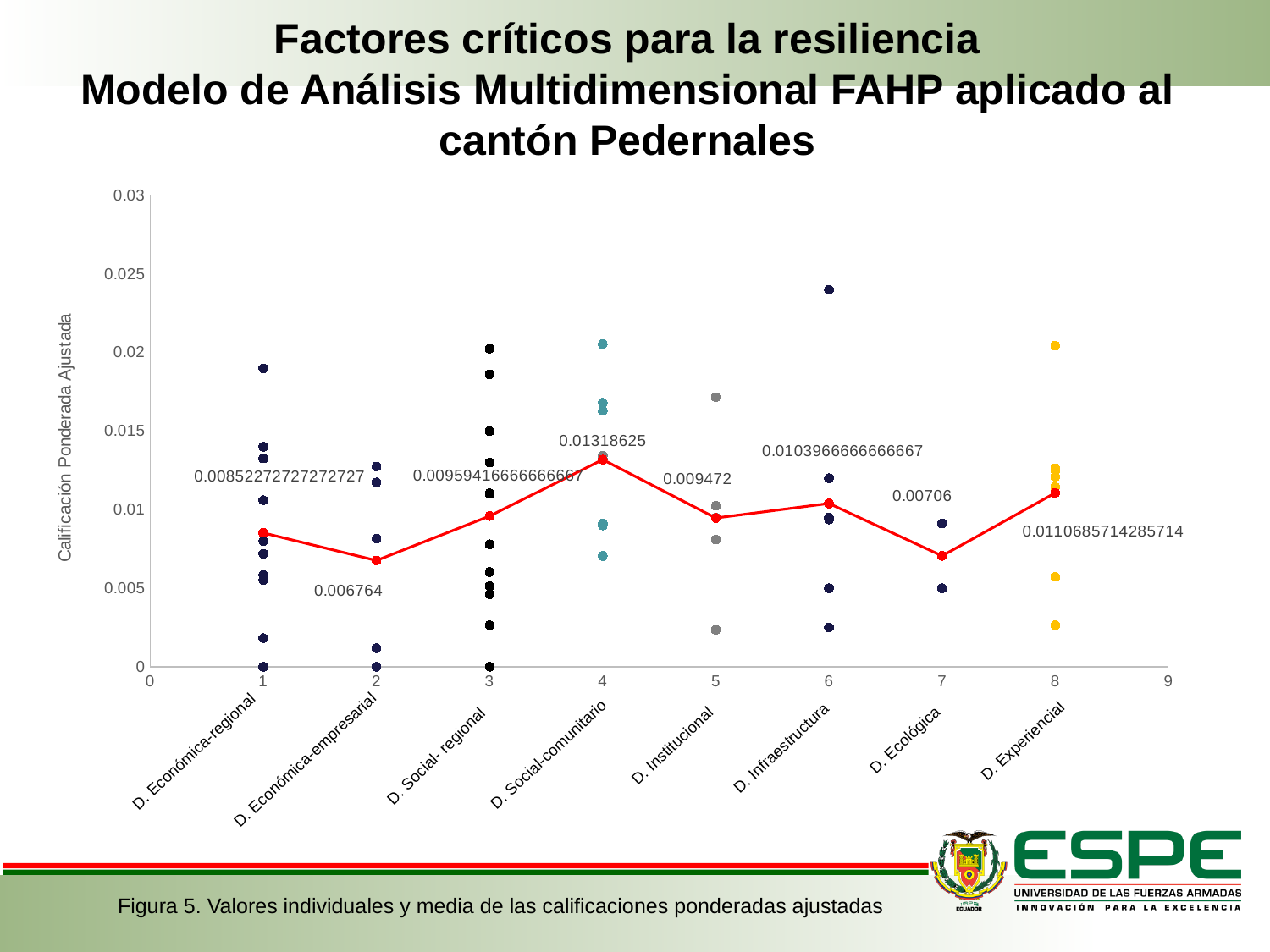
What is the mean value labelled for D. Experiencial? 0.0110685714285714 Is the highest individual point for D. Infraestructura greater or less than 0.02? greater What is the mean value labelled for D. Económica-empresarial? 0.006764 Which has a larger mean value, D. Institucional or D. Infraestructura? D. Infraestructura What is the title of the vertical axis? Calificación Ponderada Ajustada How many dimensions (categories) are plotted along the x axis? 8 What is the mean value labelled for D. Institucional? 0.009472 Which dimension has the lowest mean value on the red line? D. Económica-empresarial What is the mean value labelled for D. Ecológica? 0.00706 Which dimension has the highest mean value on the red line? D. Social-comunitario What is the difference between the highest mean (D. Social-comunitario) and the lowest mean (D. Económica-empresarial)? 0.00642225 What is the mean adjusted weighted score (red line label) for D. Social-comunitario? 0.01318625